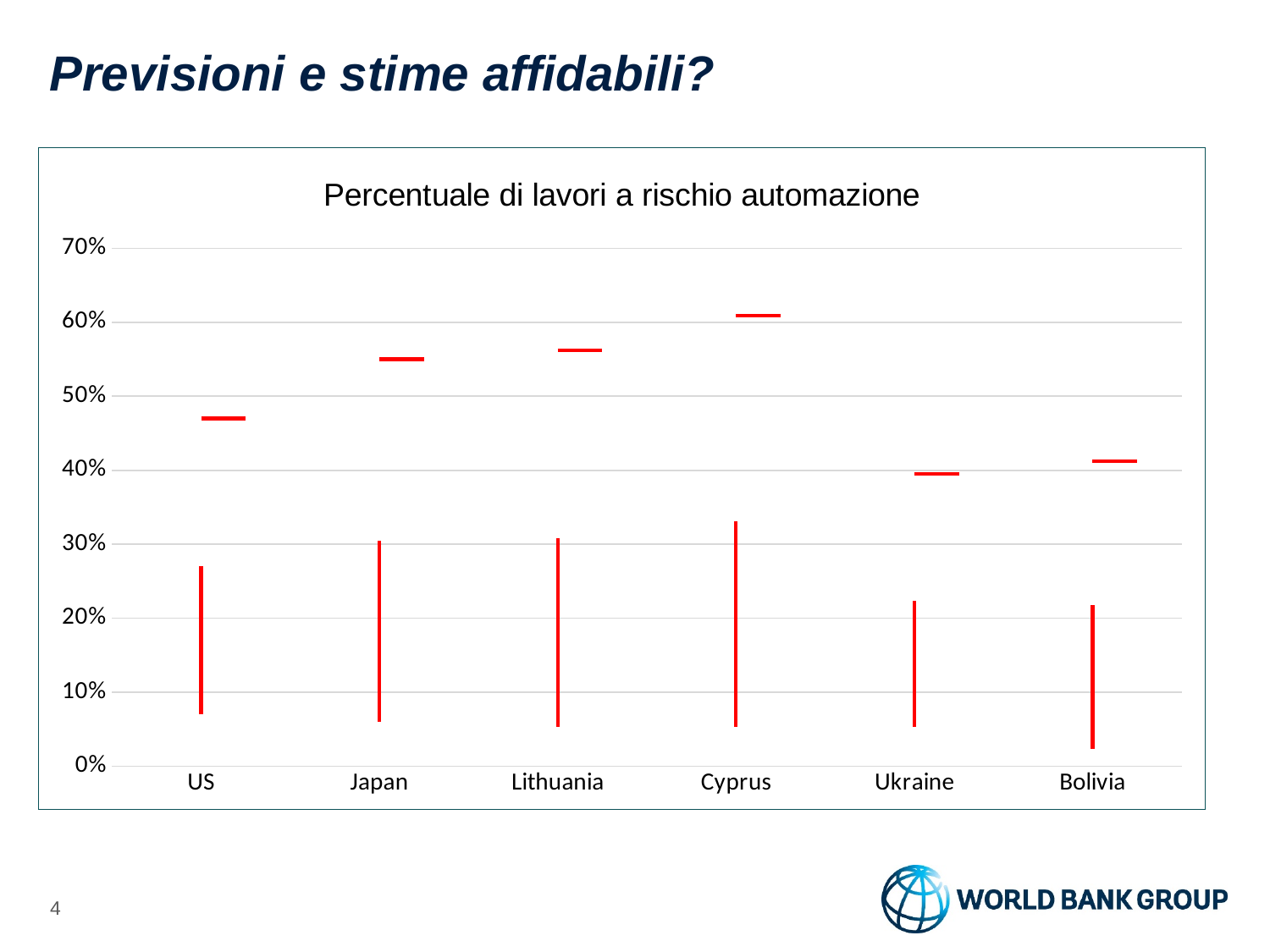
What is the title of the chart? Percentuale di lavori a rischio automazione Which country has the highest horizontal marker in the chart? Cyprus Is the top of the vertical line for Ukraine greater or less than 30%? less How many countries are shown on the x axis of the chart? 6 Is the top of the vertical line for Cyprus greater or less than 30%? greater Is the horizontal marker for Cyprus greater or less than 50%? greater Which country's vertical line reaches the lowest point on the chart? Bolivia Which has the higher horizontal marker, Cyprus or US? Cyprus What is the highest value shown on the y axis of the chart? 70%